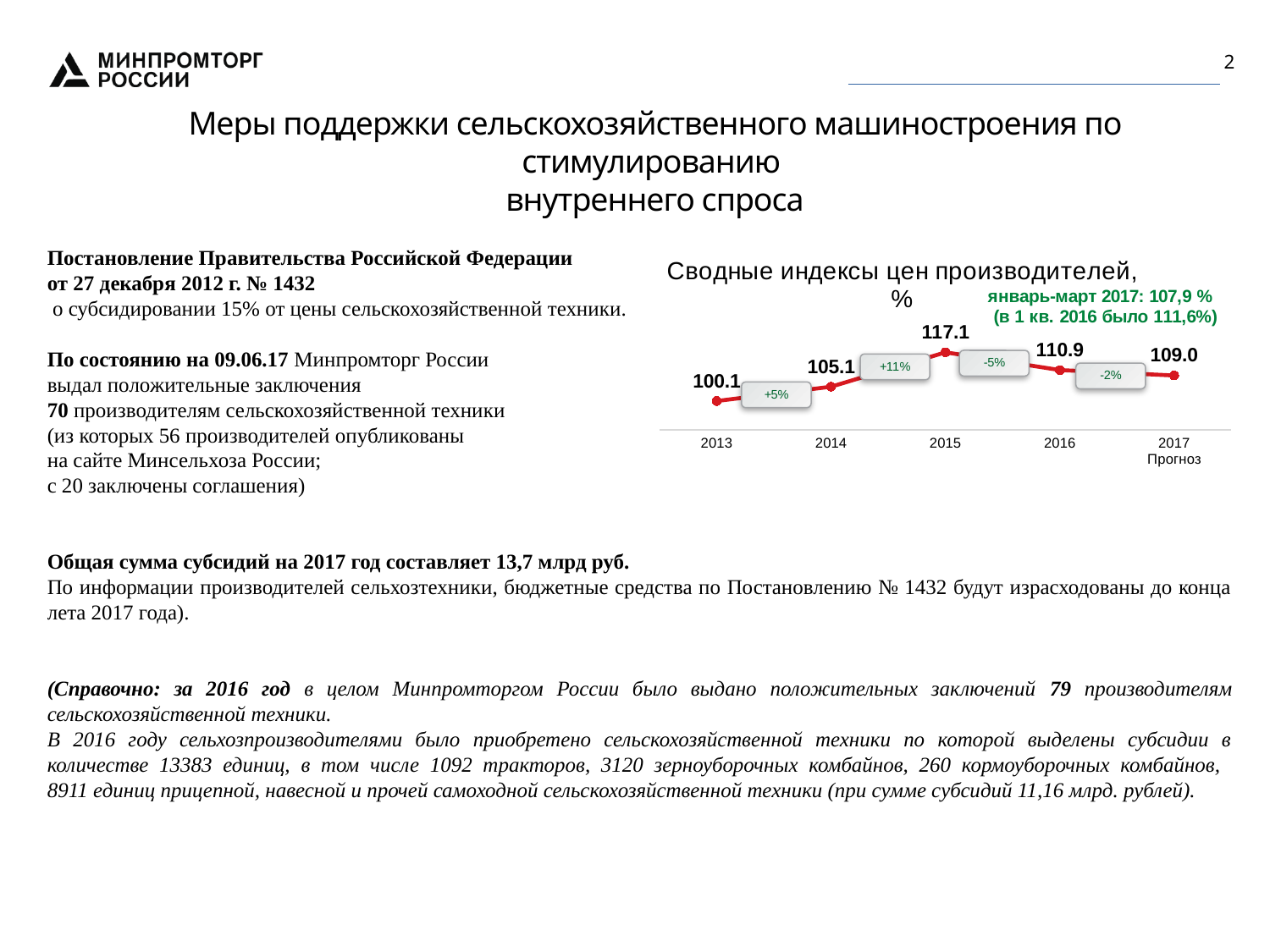
What percentage change is labelled between 2014 and 2015 on the chart? +11% What is the value of the producer price index for 2013? 100.1 What is the value of the producer price index for 2016? 110.9 Which year has the lowest producer price index? 2013 What is the difference between the producer price index in 2015 and in 2014? 12.0 What is the value of the producer price index for 2015? 117.1 How many data points are plotted on the chart? 5 What is the forecast value of the producer price index for 2017? 109.0 Does the producer price index rise or fall from 2015 to 2017? fall Which year has the highest producer price index? 2015 What type of chart is shown on the slide? line chart Which is larger, the producer price index for 2016 or for 2017? 2016